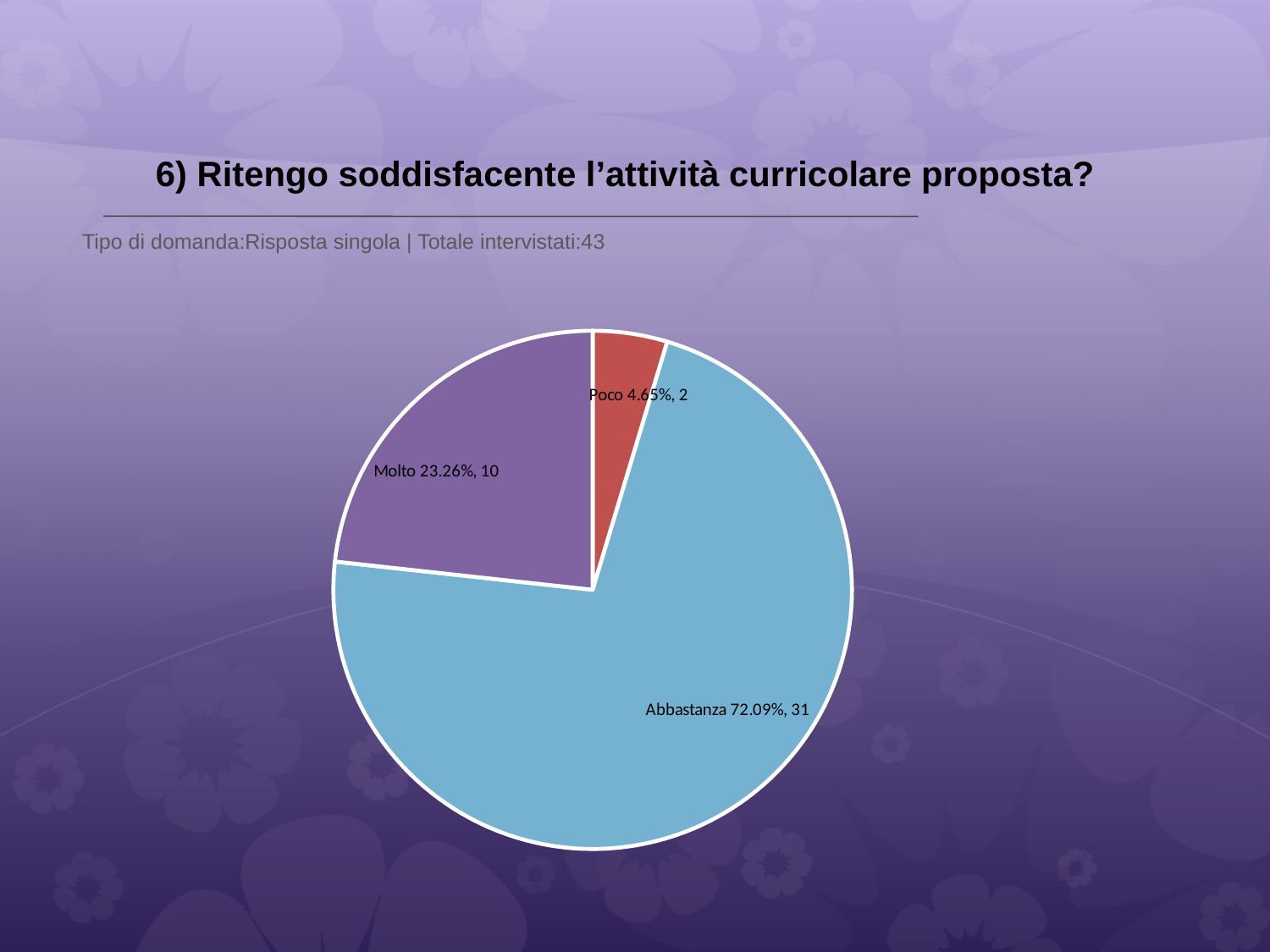
What colour is the Abbastanza slice? light blue What is the total number of respondents across all slices? 43 What percentage share does the Molto slice have? 23.26% How many slices does the pie chart have? 3 What percentage share does the Abbastanza slice have? 72.09% What is the difference in respondent count between Abbastanza and Molto? 21 Which response has the largest slice of the pie? Abbastanza How many respondents answered Molto? 10 How many respondents answered Poco? 2 Which response has the smallest slice of the pie? Poco What kind of chart is shown on the slide? pie chart Which has more respondents, Molto or Poco? Molto